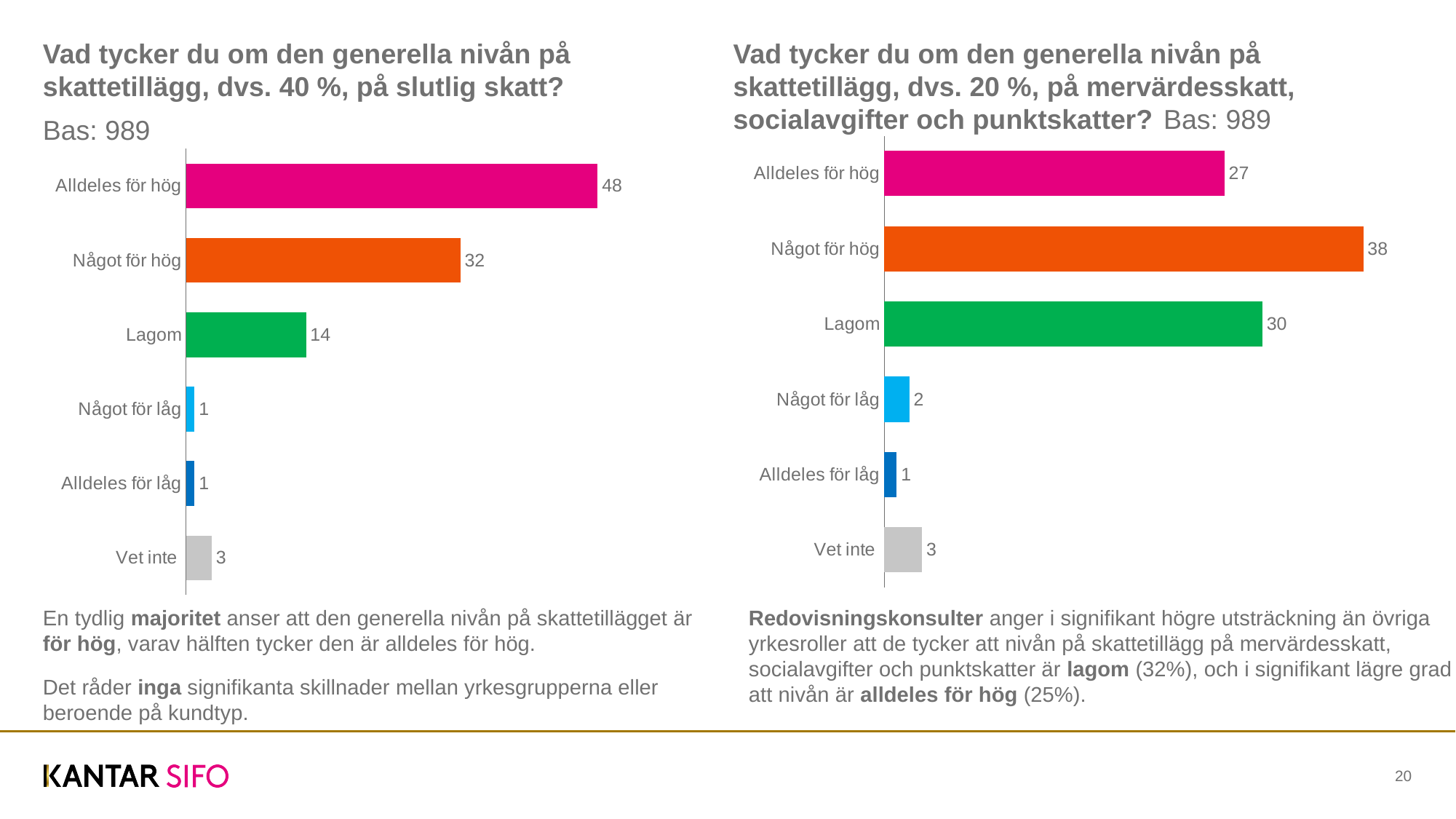
In the right chart (skattetillägg 20 %), what is the value for 'Lagom'? 30 How many categories does the left chart (skattetillägg 40 %) show? 6 In the right chart (skattetillägg 20 %), what is the difference between 'Något för hög' and 'Alldeles för hög'? 11 In the right chart (skattetillägg 20 % på mervärdesskatt, socialavgifter och punktskatter), what is the value for 'Något för hög'? 38 In the left chart (skattetillägg 40 % på slutlig skatt), what is the value for 'Alldeles för hög'? 48 What is the base (Bas) shown for the left chart (skattetillägg 40 %)? 989 In the left chart (skattetillägg 40 %), what is the difference between 'Alldeles för hög' and 'Något för hög'? 16 What kind of chart is the right chart (skattetillägg 20 %)? Bar chart In the left chart (skattetillägg 40 %), which category has the highest value? Alldeles för hög In the left chart (skattetillägg 40 %), which is larger: 'Lagom' or 'Vet inte'? Lagom In the right chart (skattetillägg 20 %), which category has the highest value? Något för hög In the right chart (skattetillägg 20 %), which category has the lowest value? Alldeles för låg